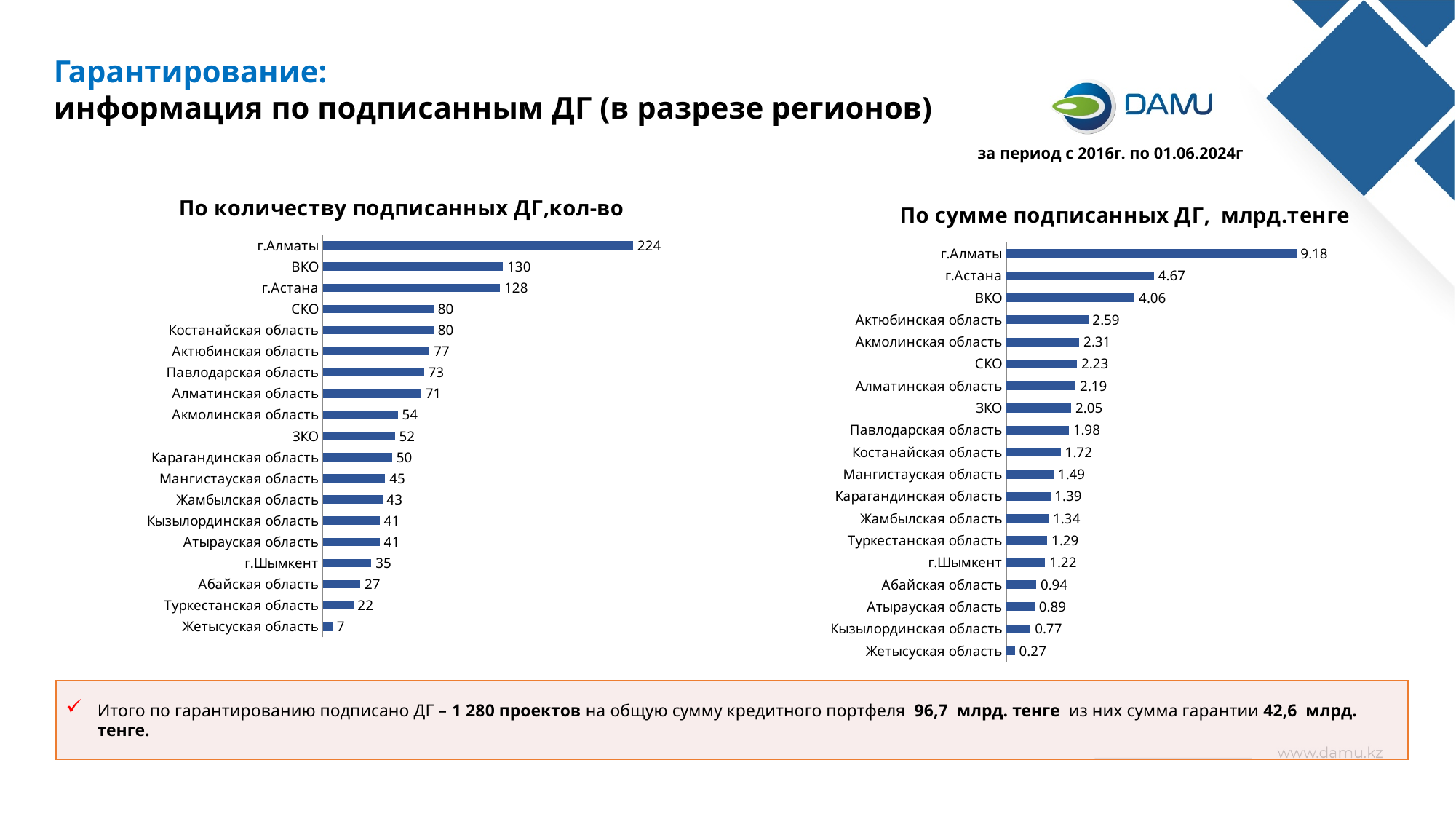
In the chart 'По количеству подписанных ДГ,кол-во', what is the value for Туркестанская область? 22 In the chart 'По количеству подписанных ДГ,кол-во', what is the value for г.Алматы? 224 What kind of chart is 'По сумме подписанных ДГ, млрд.тенге'? bar chart In the chart 'По сумме подписанных ДГ, млрд.тенге', which is larger: Актюбинская область or СКО? Актюбинская область In the chart 'По сумме подписанных ДГ, млрд.тенге', which category has the highest value? г.Алматы In the chart 'По сумме подписанных ДГ, млрд.тенге', what is the value for Жетысуская область? 0.27 In the chart 'По сумме подписанных ДГ, млрд.тенге', what is the difference between г.Алматы and ВКО? 5.12 How many categories are shown in the chart 'По количеству подписанных ДГ,кол-во'? 19 In the chart 'По количеству подписанных ДГ,кол-во', what is the difference between ВКО and г.Астана? 2 In the chart 'По количеству подписанных ДГ,кол-во', which is larger: Павлодарская область or Акмолинская область? Павлодарская область In the chart 'По количеству подписанных ДГ,кол-во', which category has the lowest value? Жетысуская область In the chart 'По сумме подписанных ДГ, млрд.тенге', what is the value for г.Астана? 4.67